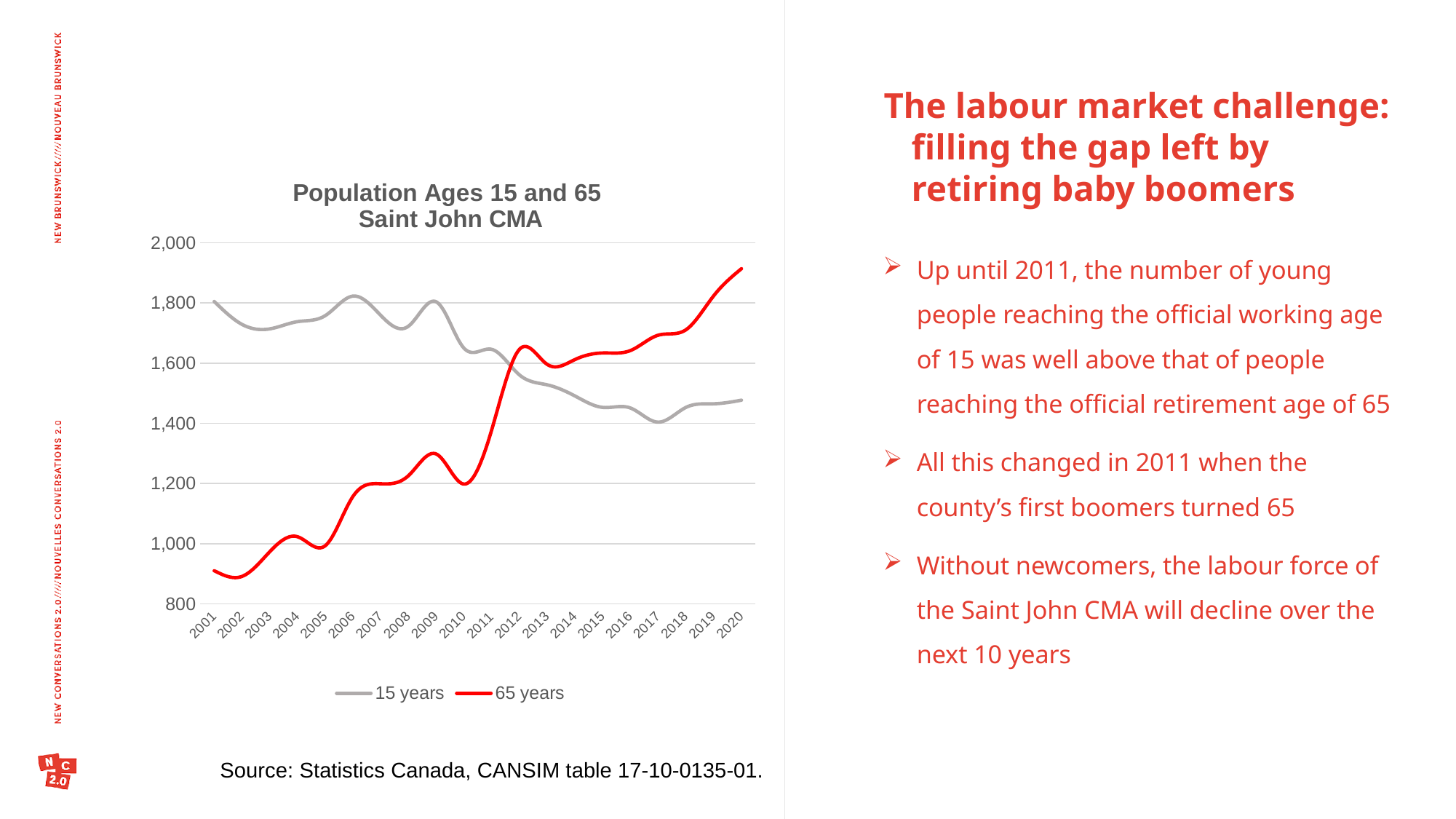
Is the value for 15 years in 2001 greater or less than 1,600? greater Is the value for 15 years in 2020 greater or less than 1,600? less How many series does the legend of the chart list? 2 What is the title of the chart? Population Ages 15 and 65 Saint John CMA Does the 65 years series generally rise or fall from 2001 to 2020? rise In 2020, which series has the larger value, 15 years or 65 years? 65 years In 2001, which series has the larger value, 15 years or 65 years? 15 years Is the value for 65 years in 2020 greater or less than 1,800? greater How many years are shown on the x axis of the chart? 20 What kind of chart is shown on the slide? Line chart Which series is drawn in red on the chart? 65 years